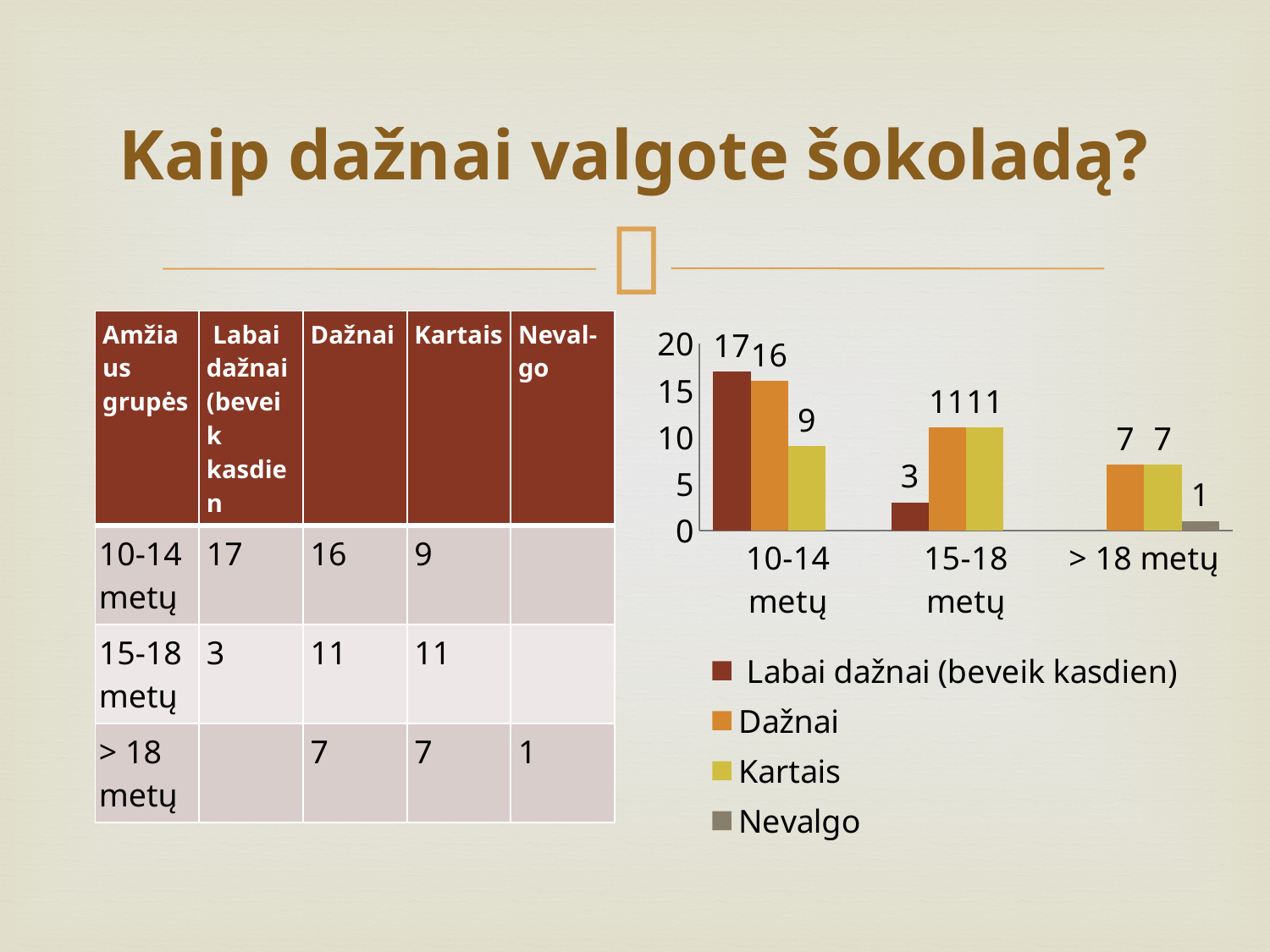
Which age group has the highest value for 'Labai dažnai (beveik kasdien)'? 10-14 metų Which series in the legend is shown in grey? Nevalgo What kind of chart is shown on the slide? bar chart What is the value for 'Kartais' in the 10-14 metų group? 9 What is the value for 'Nevalgo' in the > 18 metų group? 1 What is the difference between the 'Dažnai' values for the 10-14 metų and 15-18 metų groups? 5 Which age group has the lowest value for 'Dažnai'? > 18 metų How many series does the chart legend list? 4 What is the value for 'Labai dažnai (beveik kasdien)' in the 10-14 metų group? 17 What is the value for 'Dažnai' in the 15-18 metų group? 11 Which is larger: 'Labai dažnai (beveik kasdien)' for 10-14 metų or 'Labai dažnai (beveik kasdien)' for 15-18 metų? 10-14 metų How many age-group categories are shown on the x axis of the chart? 3